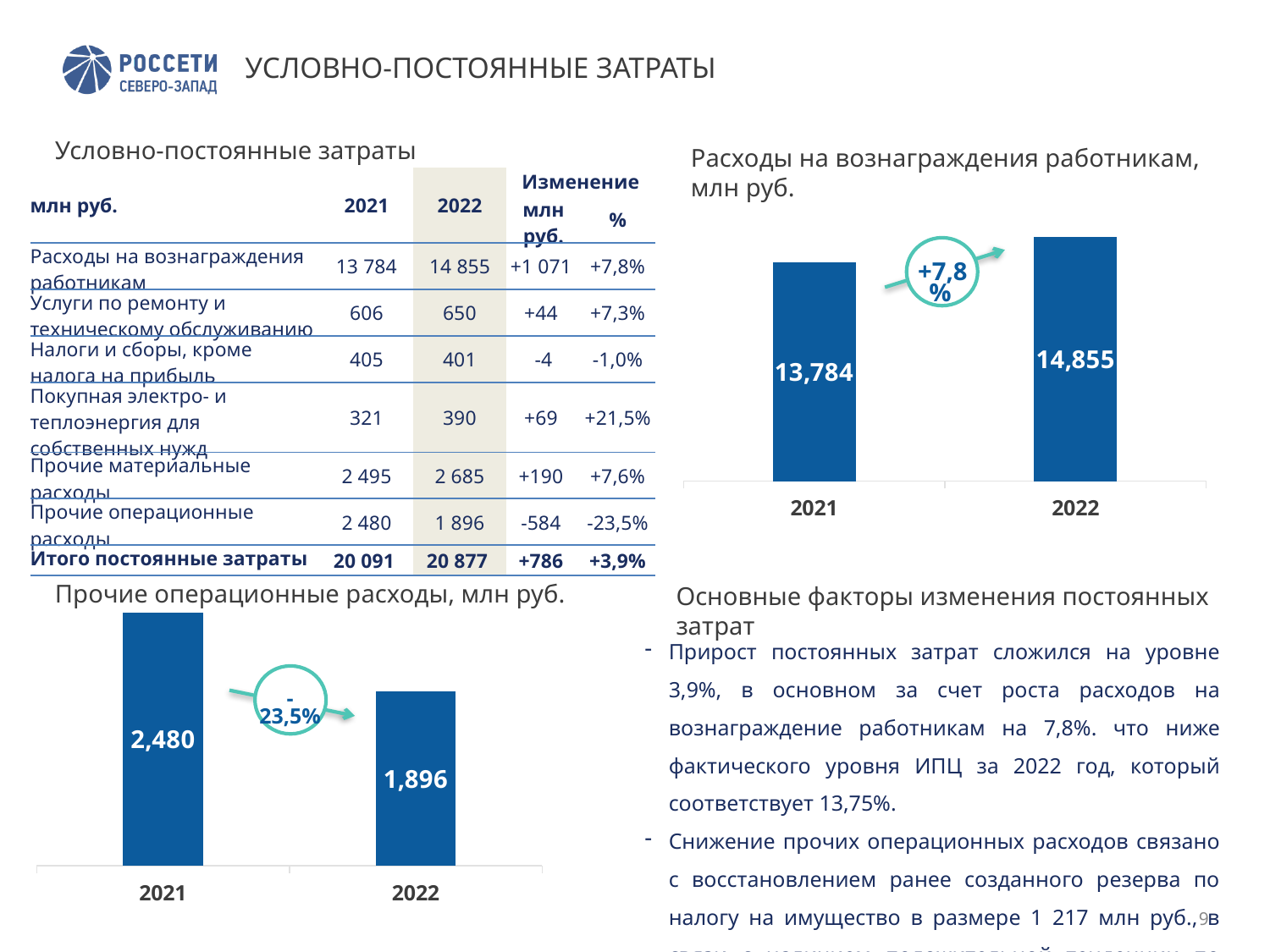
In the chart 'Расходы на вознаграждения работникам, млн руб.', what is the value for 2022? 14,855 In the chart 'Расходы на вознаграждения работникам, млн руб.', which year has the higher value? 2022 In the chart 'Прочие операционные расходы, млн руб.', what is the value for 2021? 2,480 How many years are plotted in the chart 'Расходы на вознаграждения работникам, млн руб.'? 2 In the chart 'Расходы на вознаграждения работникам, млн руб.', what is the difference between the 2022 and 2021 values? 1,071 In the chart 'Прочие операционные расходы, млн руб.', do the values rise or fall from 2021 to 2022? fall What type of chart is 'Прочие операционные расходы, млн руб.'? bar chart In the chart 'Расходы на вознаграждения работникам, млн руб.', what is the value for 2021? 13,784 In the chart 'Расходы на вознаграждения работникам, млн руб.', what percentage change is shown between 2021 and 2022? +7,8% In the chart 'Прочие операционные расходы, млн руб.', what is the difference between the 2021 and 2022 values? 584 In the chart 'Прочие операционные расходы, млн руб.', what is the value for 2022? 1,896 In the chart 'Прочие операционные расходы, млн руб.', which year has the lower value? 2022